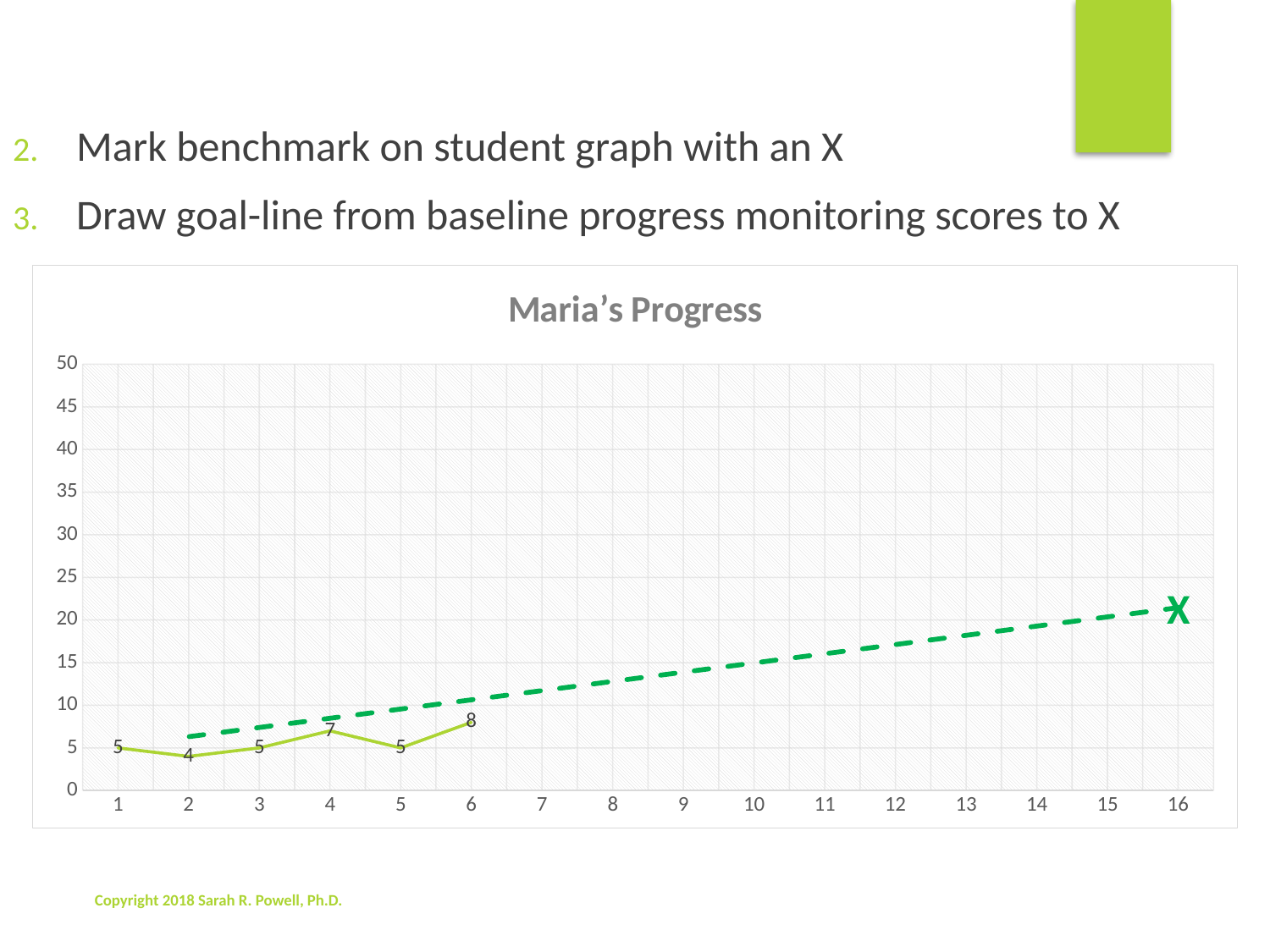
What kind of chart is shown on the slide? line chart What is Maria's score at point 2? 4 What is Maria's score at point 4? 7 What is the title of the chart? Maria's Progress Is the value at the X benchmark mark at point 16 greater or less than 15? greater What is Maria's score at point 1? 5 How many data points have labeled scores on Maria's progress line? 6 Which is larger, Maria's score at point 4 or at point 5? point 4 At which point is Maria's plotted score lowest? 2 What is Maria's score at point 6? 8 At which point is Maria's plotted score highest? 6 What is the difference between Maria's score at point 6 and her score at point 2? 4